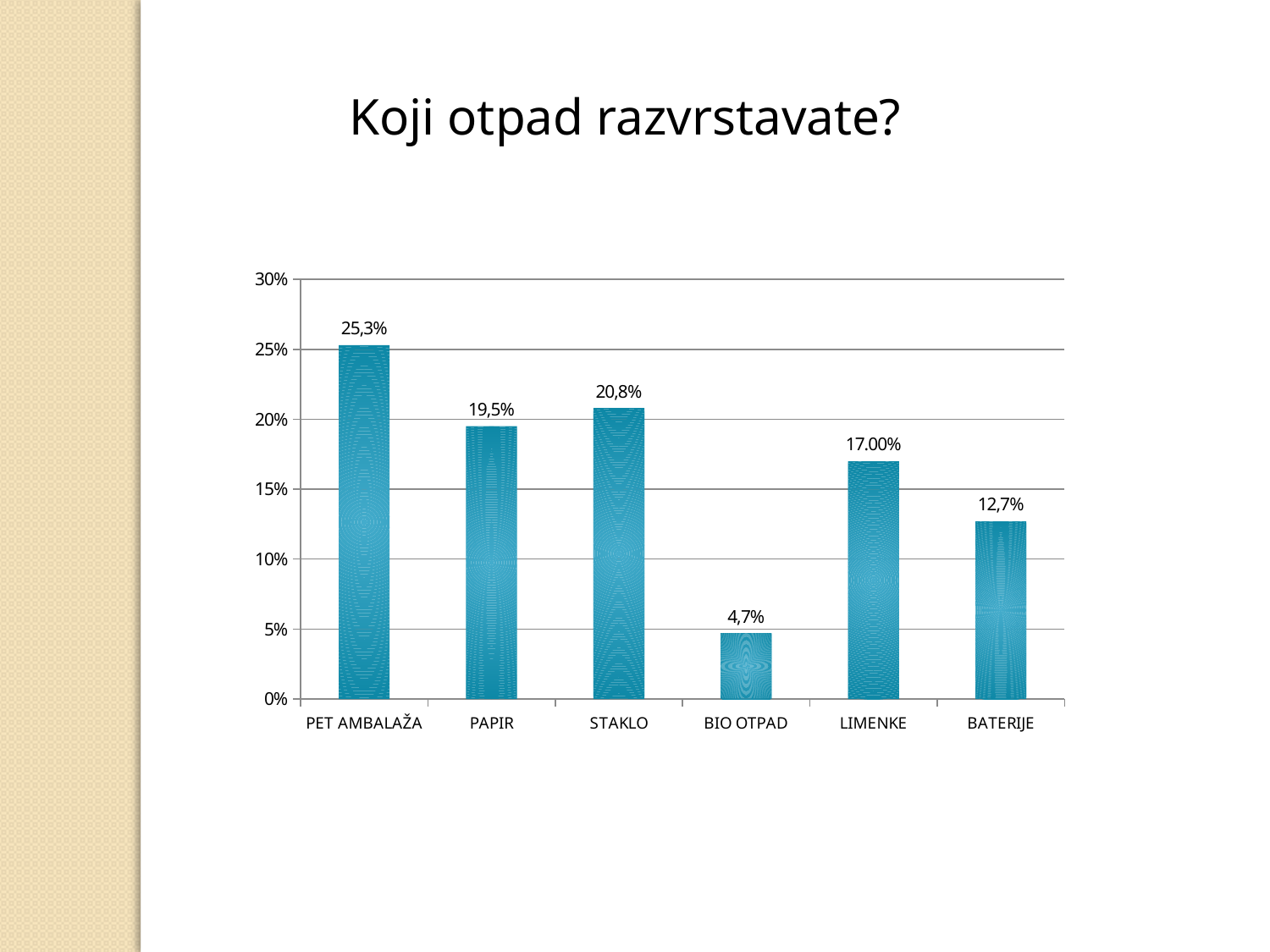
What is the difference between the values for STAKLO and BIO OTPAD? 16,1 percentage points What is the difference between the values for PET AMBALAŽA and PAPIR? 5,8 percentage points What kind of chart is shown on the slide? Bar chart What is the value for BATERIJE? 12,7% Which category has the highest value? PET AMBALAŽA What is the title of the chart? Koji otpad razvrstavate? What is the value for LIMENKE? 17.00% Which is larger, the value for STAKLO or the value for PAPIR? STAKLO Which category has the lowest value? BIO OTPAD How many categories are shown on the x axis? 6 What is the value for PET AMBALAŽA? 25,3% What is the value for BIO OTPAD? 4,7%